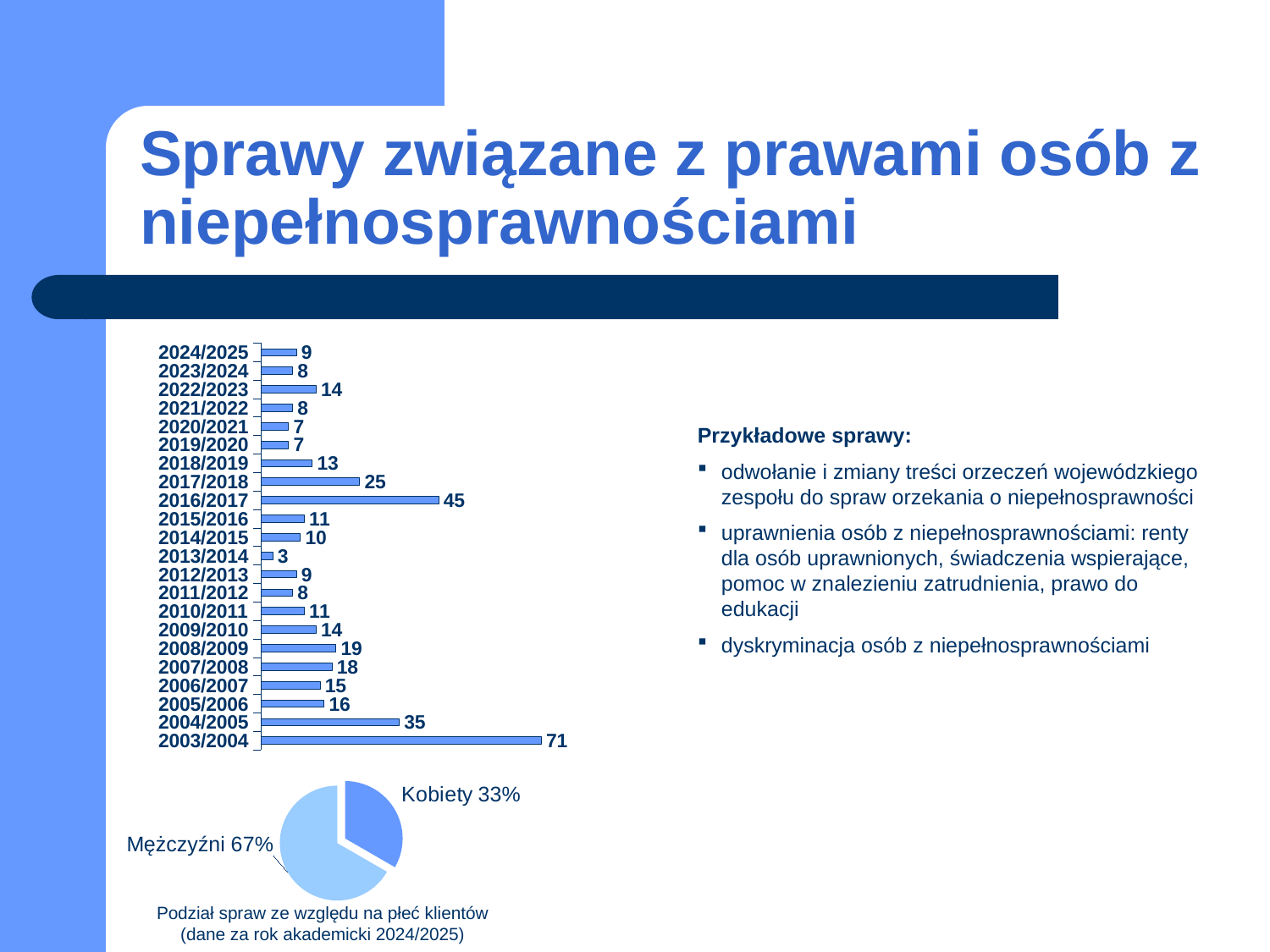
How many academic years are shown in the bar chart? 22 In the bar chart, what is the difference between the values for 2003/2004 and 2004/2005? 36 In the bar chart, what is the value for 2016/2017? 45 What is the caption under the pie chart? Podział spraw ze względu na płeć klientów (dane za rok akademicki 2024/2025) In the bar chart, which academic year has the lowest value? 2013/2014 In the pie chart, what share is labelled Kobiety? 33% In the bar chart, which academic year has the highest value? 2003/2004 In the bar chart, which is larger, the value for 2017/2018 or the value for 2018/2019? 2017/2018 In the pie chart, what share is labelled Mężczyźni? 67% What kind of chart is the chart showing values by academic year? bar chart In the bar chart, what is the value for 2024/2025? 9 In the pie chart, which slice is larger, Kobiety or Mężczyźni? Mężczyźni